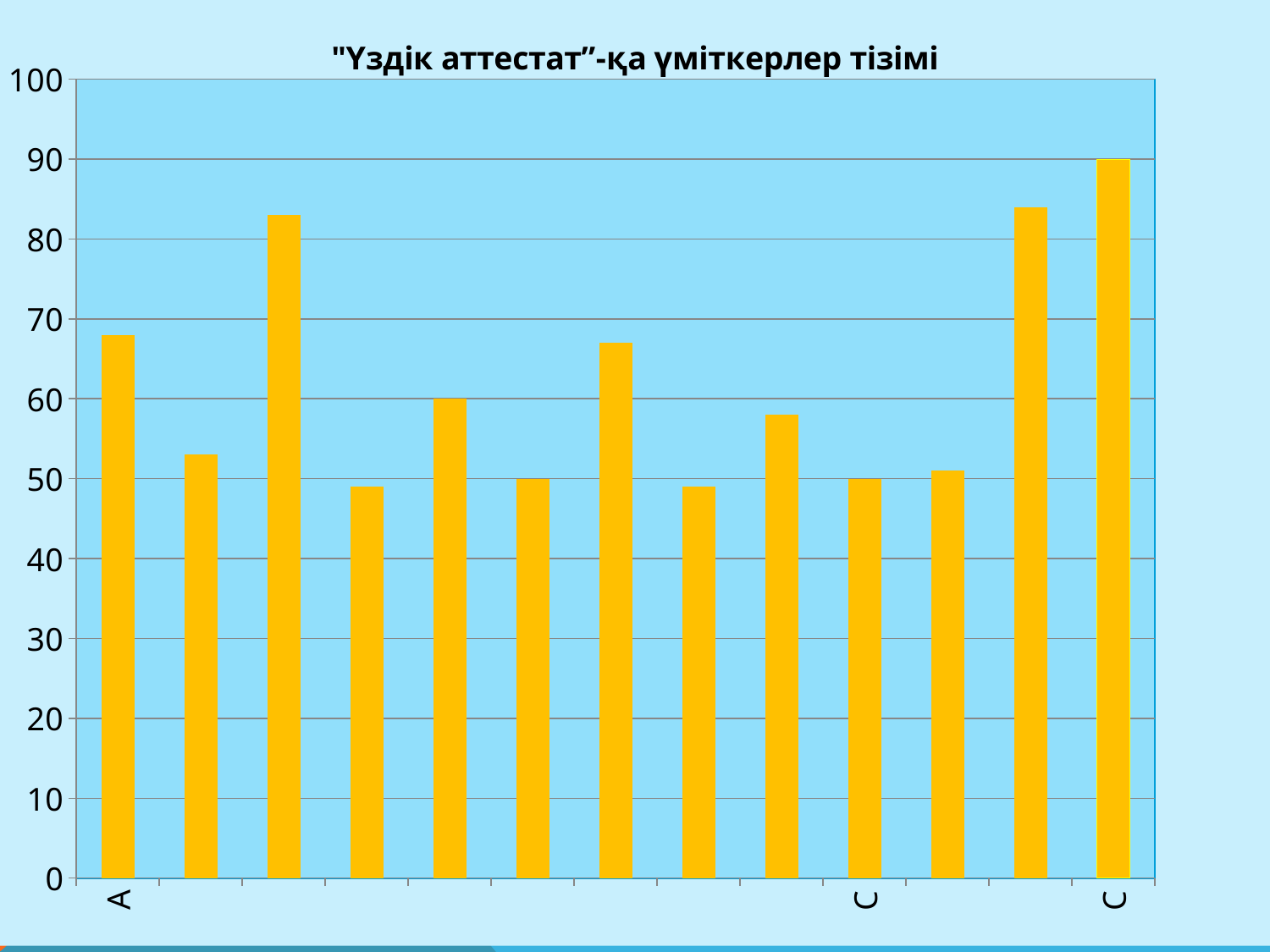
Which is larger, the value for A or the value of the rightmost bar labeled C? the rightmost bar labeled C How many bars are plotted in the chart? 13 Is the value of the second bar from the left greater or less than 60? less Is the value for A greater or less than 70? less What kind of chart is shown on the slide? bar chart Is the value of the rightmost bar labeled C greater or less than 80? greater What is the highest value shown on the vertical axis? 100 Which bar is the highest in the chart? the rightmost bar, labeled C What is the value of the rightmost bar, labeled C? 90 What is the title of the chart? "Үздік аттестат"-қа үміткерлер тізімі